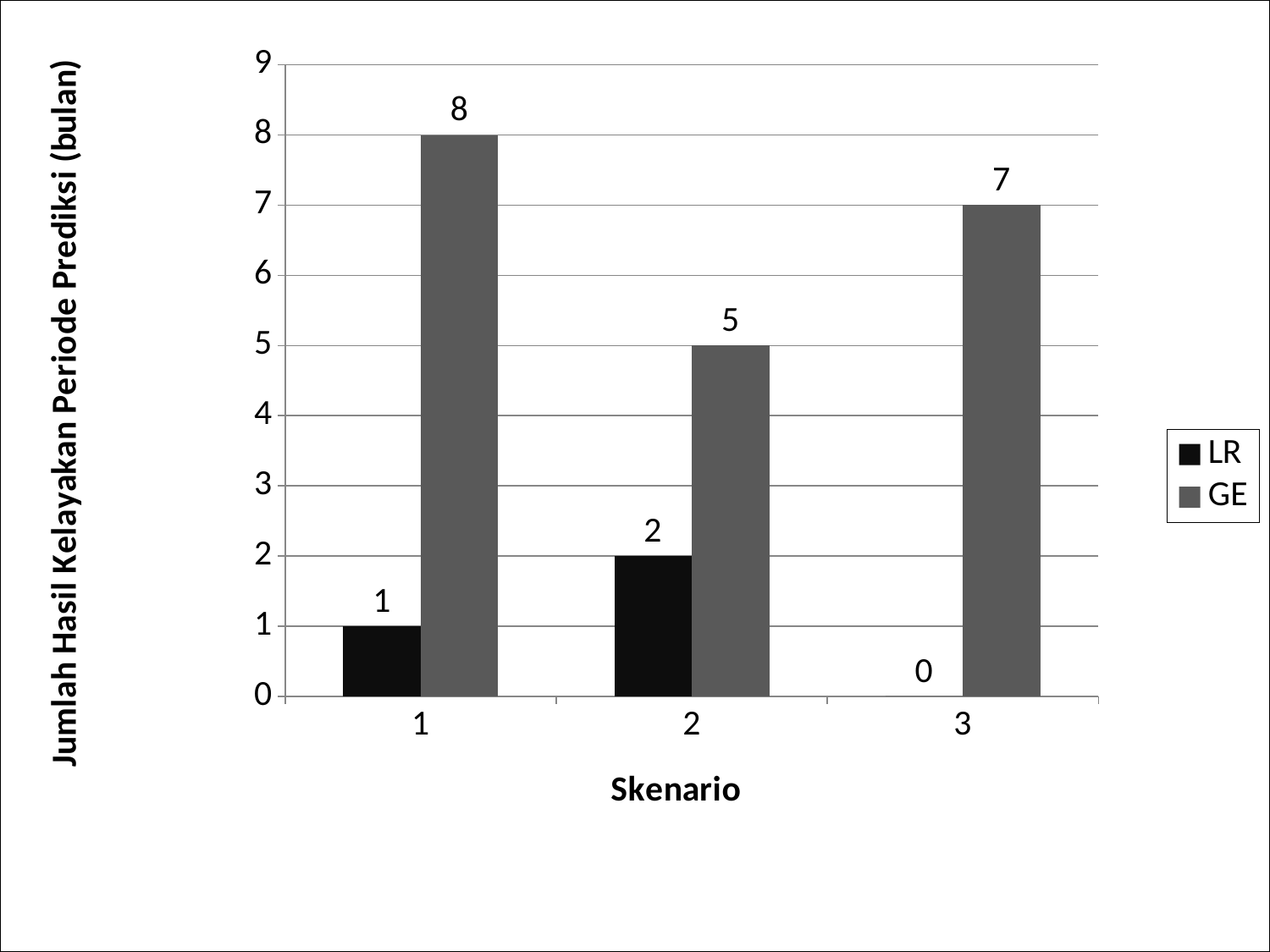
Which Skenario has the highest GE value? 1 What kind of chart is shown on the slide? Bar chart What is the value for LR in Skenario 2? 2 What is the label of the y axis? Jumlah Hasil Kelayakan Periode Prediksi (bulan) What is the difference between the GE and LR values in Skenario 2? 3 How many Skenario categories are shown on the x axis? 3 How many series does the legend list? 2 Which is larger, the GE value in Skenario 2 or the GE value in Skenario 3? GE in Skenario 3 What is the value for GE in Skenario 3? 7 What is the value for LR in Skenario 3? 0 What is the value for GE in Skenario 1? 8 Which Skenario has the lowest LR value? 3